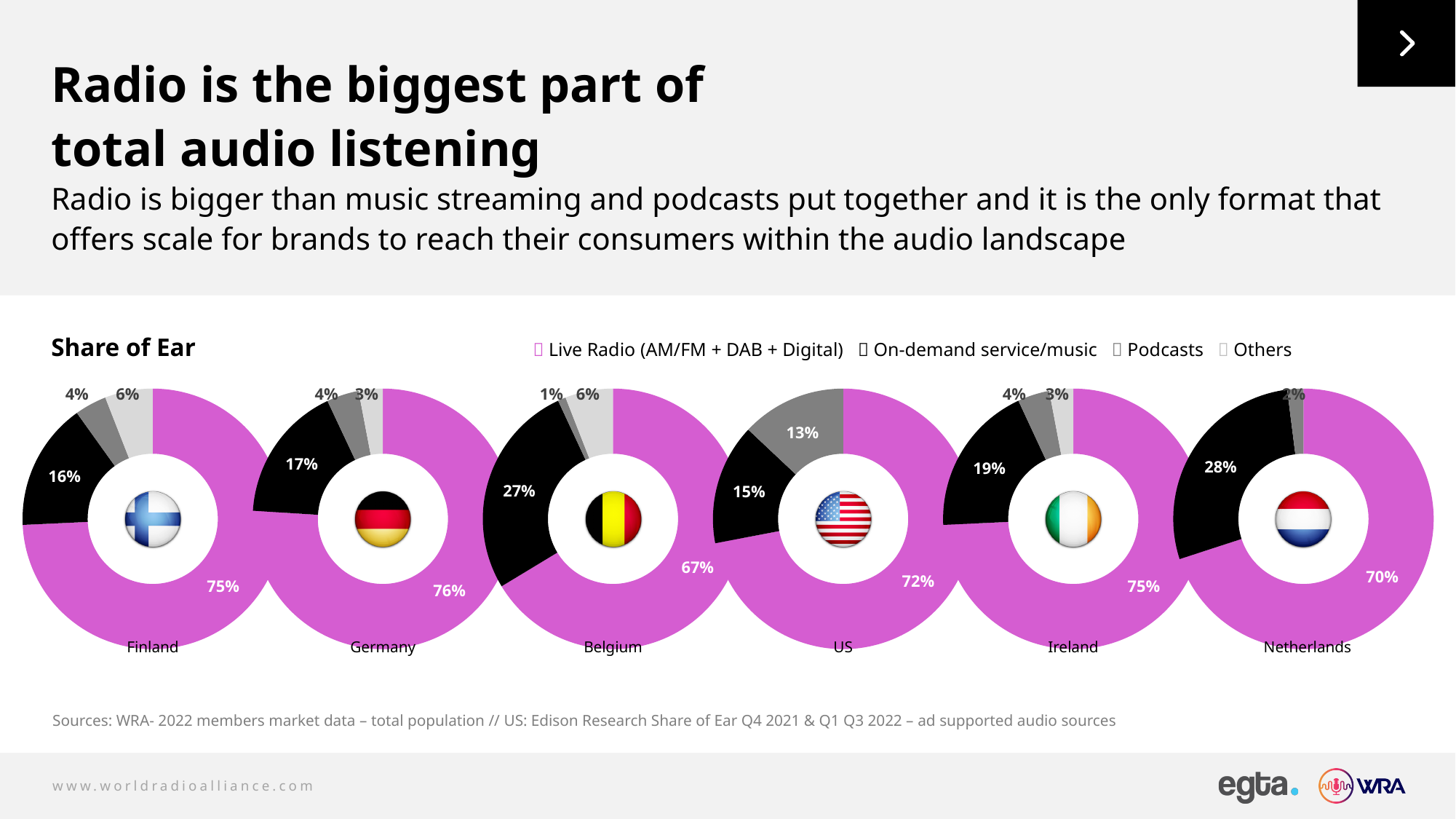
In the Netherlands chart, what is the share for On-demand service/music? 28% Which is larger: the On-demand service/music share in Ireland or in Germany? Ireland Across the six country charts, which country has the highest Live Radio share? Germany In the US chart, what is the share for Podcasts? 13% How many country charts are shown on the slide? 6 In the Belgium chart, what is the share for On-demand service/music? 27% How many categories does the legend list? 4 Across the six country charts, which country has the lowest Live Radio share? Belgium In the Finland chart, what is the share for Live Radio (AM/FM + DAB + Digital)? 75% What kind of chart is used for each country? Donut chart What is the title of the chart section on the slide? Share of Ear What is the difference between the Live Radio share in Germany and in Belgium? 9%